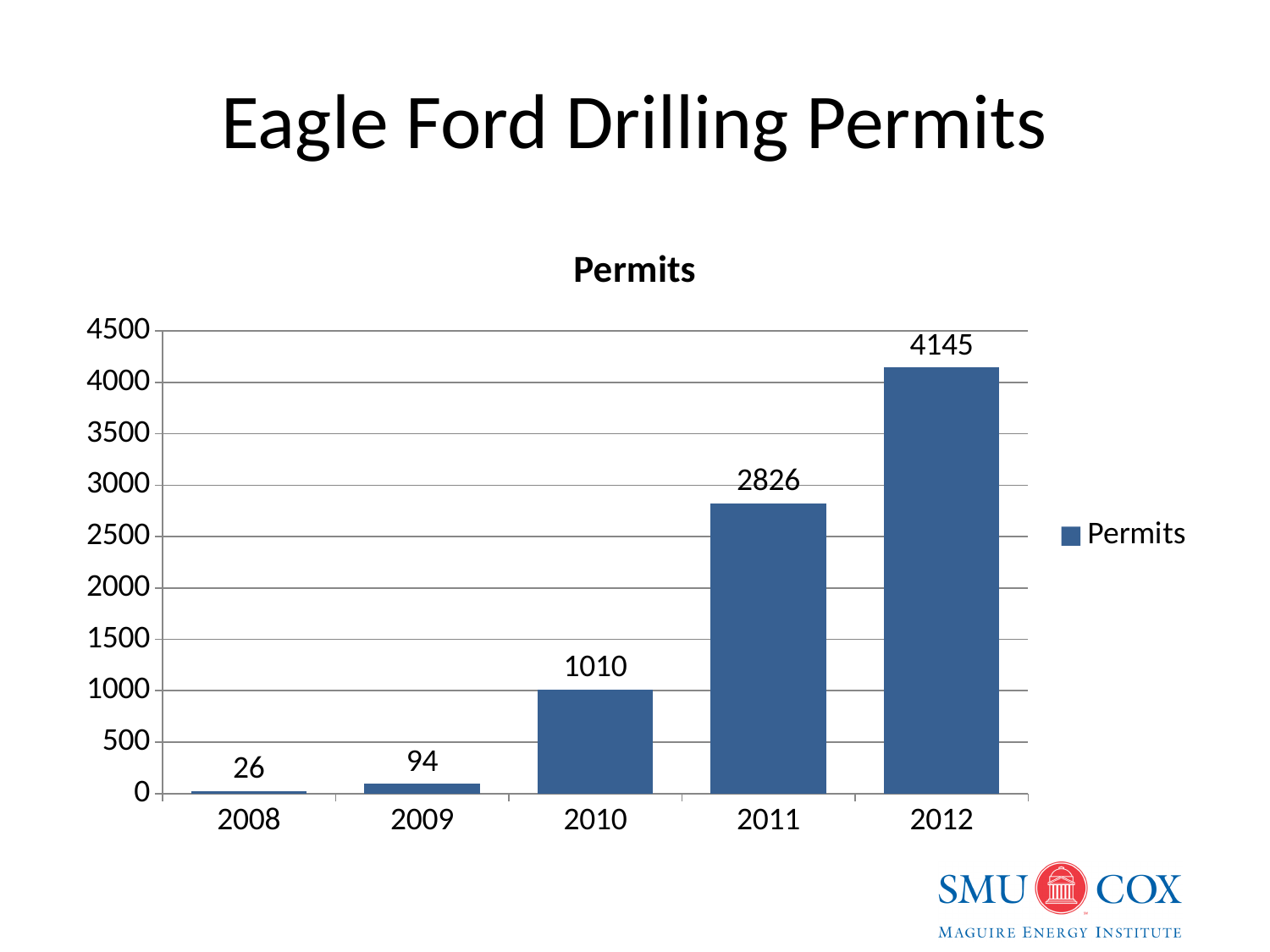
What is the number of permits for 2012? 4145 Is the value for 2011 greater or less than 2500? greater What is the difference in permits between 2009 and 2008? 68 What kind of chart is shown on the slide? Bar chart What is the number of permits for 2008? 26 Which year has the lowest number of permits? 2008 Do the permit values rise or fall from 2008 to 2012? Rise Which year has more permits, 2010 or 2011? 2011 What is the difference in permits between 2012 and 2011? 1319 What is the number of permits for 2010? 1010 Which year has the highest number of permits? 2012 How many years are shown on the x axis? 5